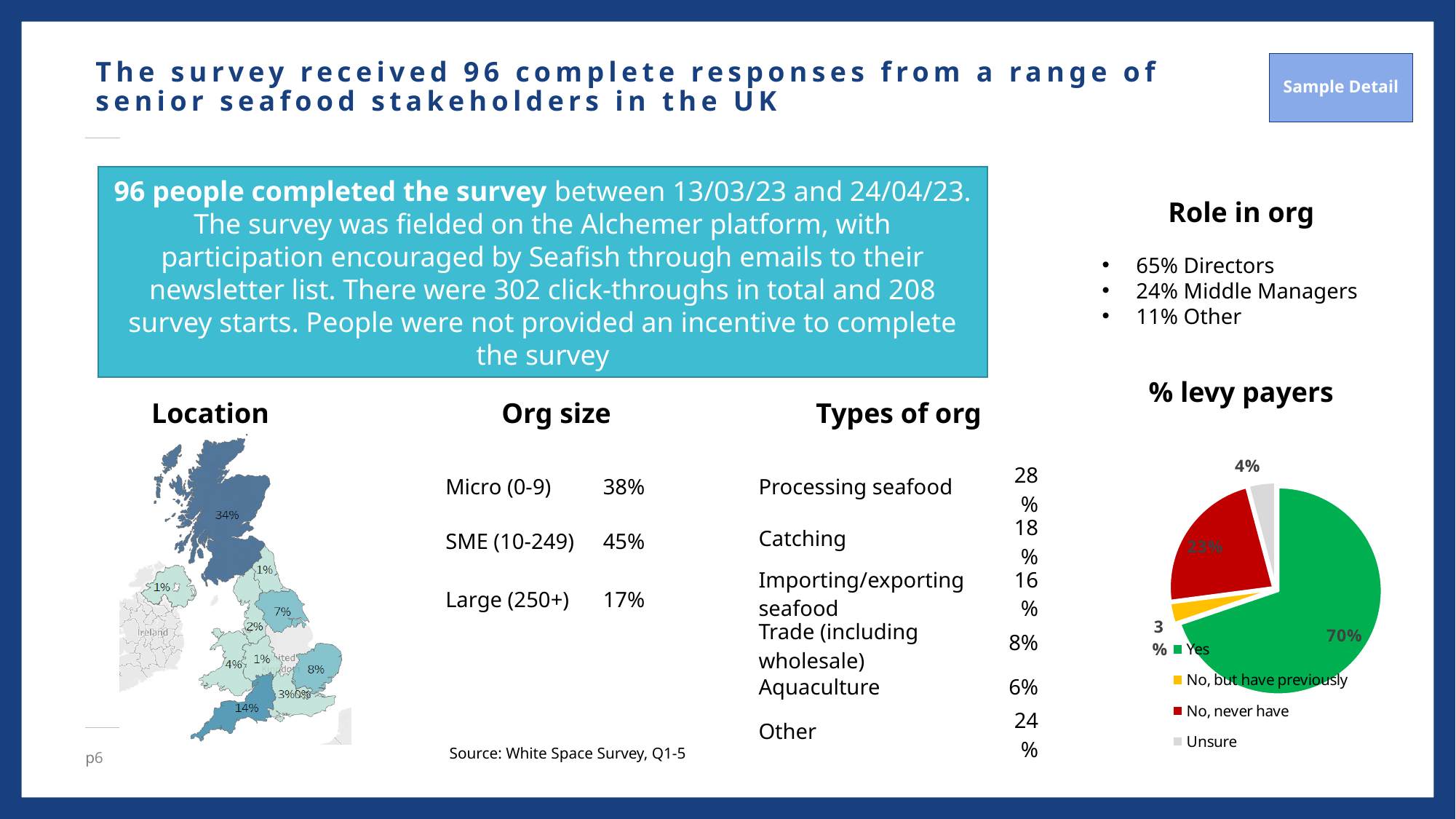
In the "% levy payers" pie chart, what share of respondents answered "No, but have previously"? 3% In the "% levy payers" pie chart, what share of respondents answered "Unsure"? 4% In the "% levy payers" pie chart, which category has the largest slice? Yes In the "% levy payers" pie chart, what is the difference between the "Yes" share and the "No, never have" share? 47% In the "% levy payers" pie chart, what share of respondents answered "No, never have"? 23% How many categories does the legend of the "% levy payers" pie chart list? 4 In the "% levy payers" pie chart, what colour is the "No, never have" slice? red In the "% levy payers" pie chart, which category has the smallest slice? No, but have previously What kind of chart is the "% levy payers" chart? pie chart In the "% levy payers" pie chart, which is larger: "Unsure" or "No, but have previously"? Unsure In the "% levy payers" pie chart, what colour is the "Yes" slice? green In the "% levy payers" pie chart, what share of respondents answered "Yes"? 70%